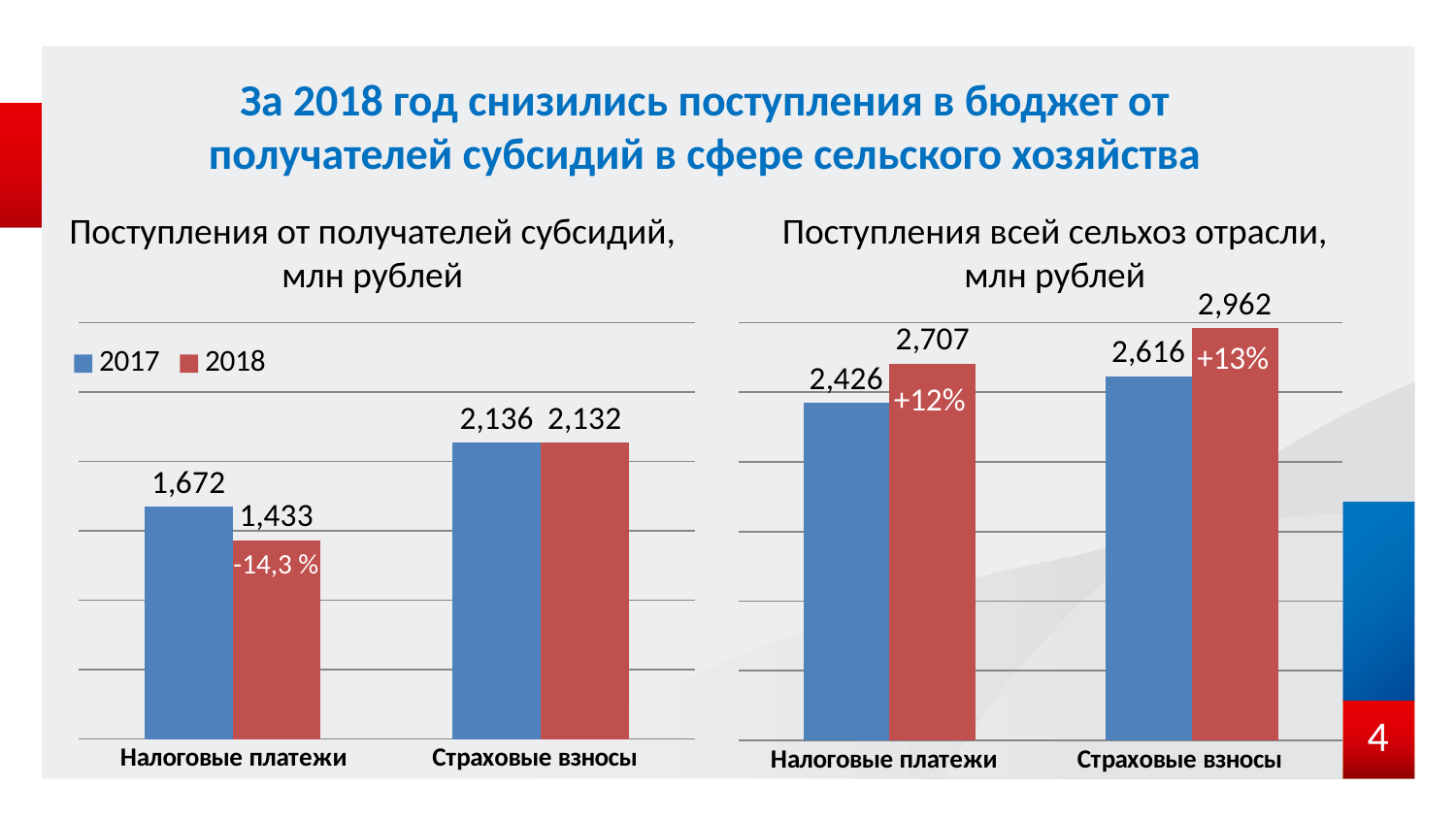
What percentage change is printed on the 2018 bar for Налоговые платежи in the left chart (Поступления от получателей субсидий)? -14,3 % In the right chart (Поступления всей сельхоз отрасли), which category has the highest 2018 value? Страховые взносы In the left chart (Поступления от получателей субсидий), what is the 2018 value for Налоговые платежи? 1,433 In the left chart (Поступления от получателей субсидий), what is the 2018 value for Страховые взносы? 2,132 In the left chart (Поступления от получателей субсидий), what is the difference between the 2017 and 2018 values for Налоговые платежи? 239 In the right chart (Поступления всей сельхоз отрасли), what is the difference between the 2018 and 2017 values for Налоговые платежи? 281 What type of chart is the right chart (Поступления всей сельхоз отрасли)? Bar chart In the left chart (Поступления от получателей субсидий), what is the 2017 value for Налоговые платежи? 1,672 In the left chart (Поступления от получателей субсидий), which is larger for Налоговые платежи: the 2017 value or the 2018 value? 2017 In the right chart (Поступления всей сельхоз отрасли), what is the 2017 value for Налоговые платежи? 2,426 In the right chart (Поступления всей сельхоз отрасли), what is the 2018 value for Страховые взносы? 2,962 How many series does the legend of the left chart (Поступления от получателей субсидий) list? 2